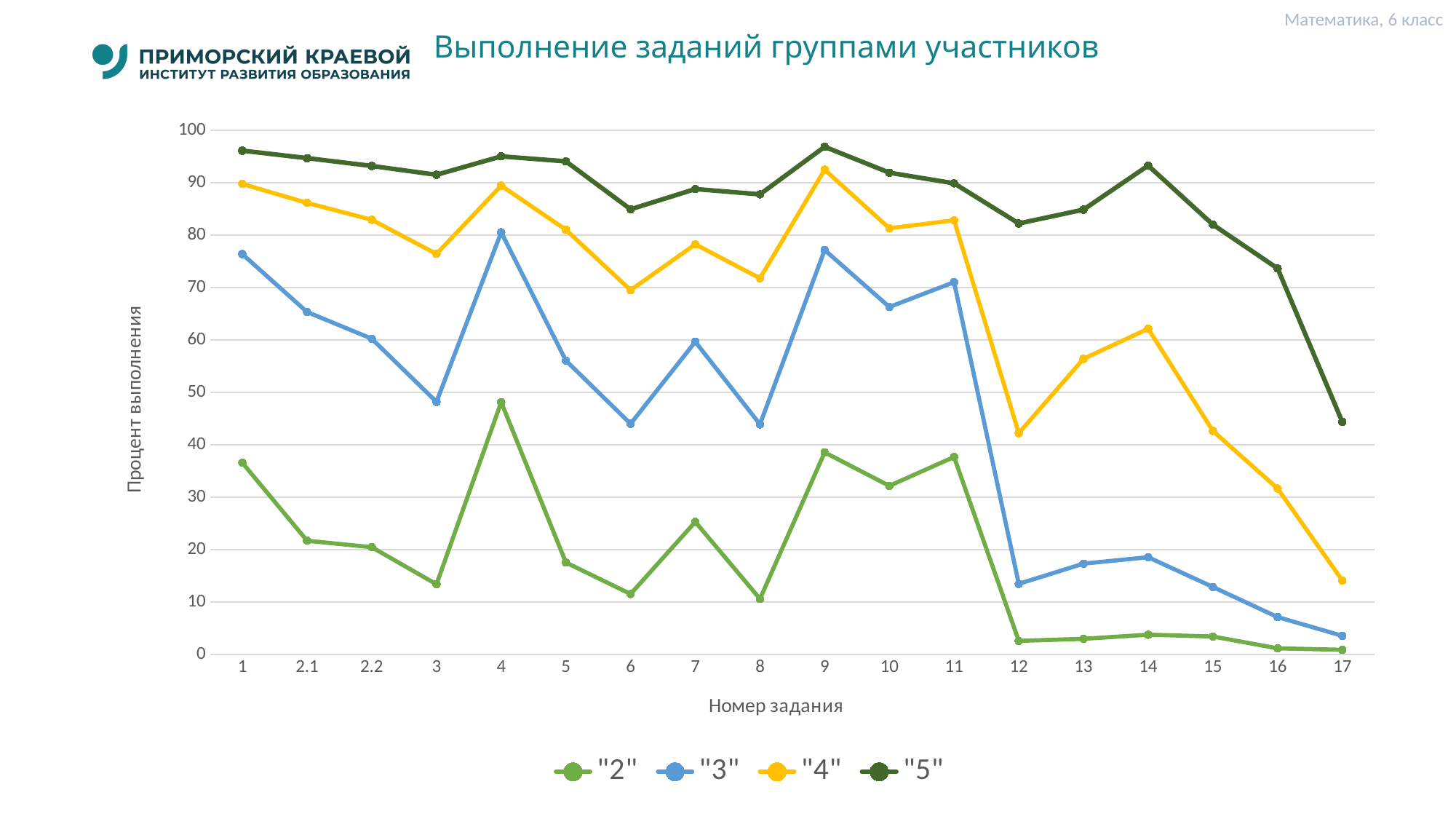
How many series does the legend list? 4 For series "2", which task number has the highest value? 4 At task 9, which series has the larger value, "3" or "4"? "4" Is the value for series "2" at task 12 greater or less than 10? less Is the value for series "3" at task 4 greater or less than 70? greater What is the title of the chart? Выполнение заданий группами участников Is the value for series "5" at task 17 greater or less than 40? greater How many task numbers are shown along the x axis? 18 What is the label of the y axis? Процент выполнения What kind of chart is shown on the slide? line chart For series "5", which task number has the lowest value? 17